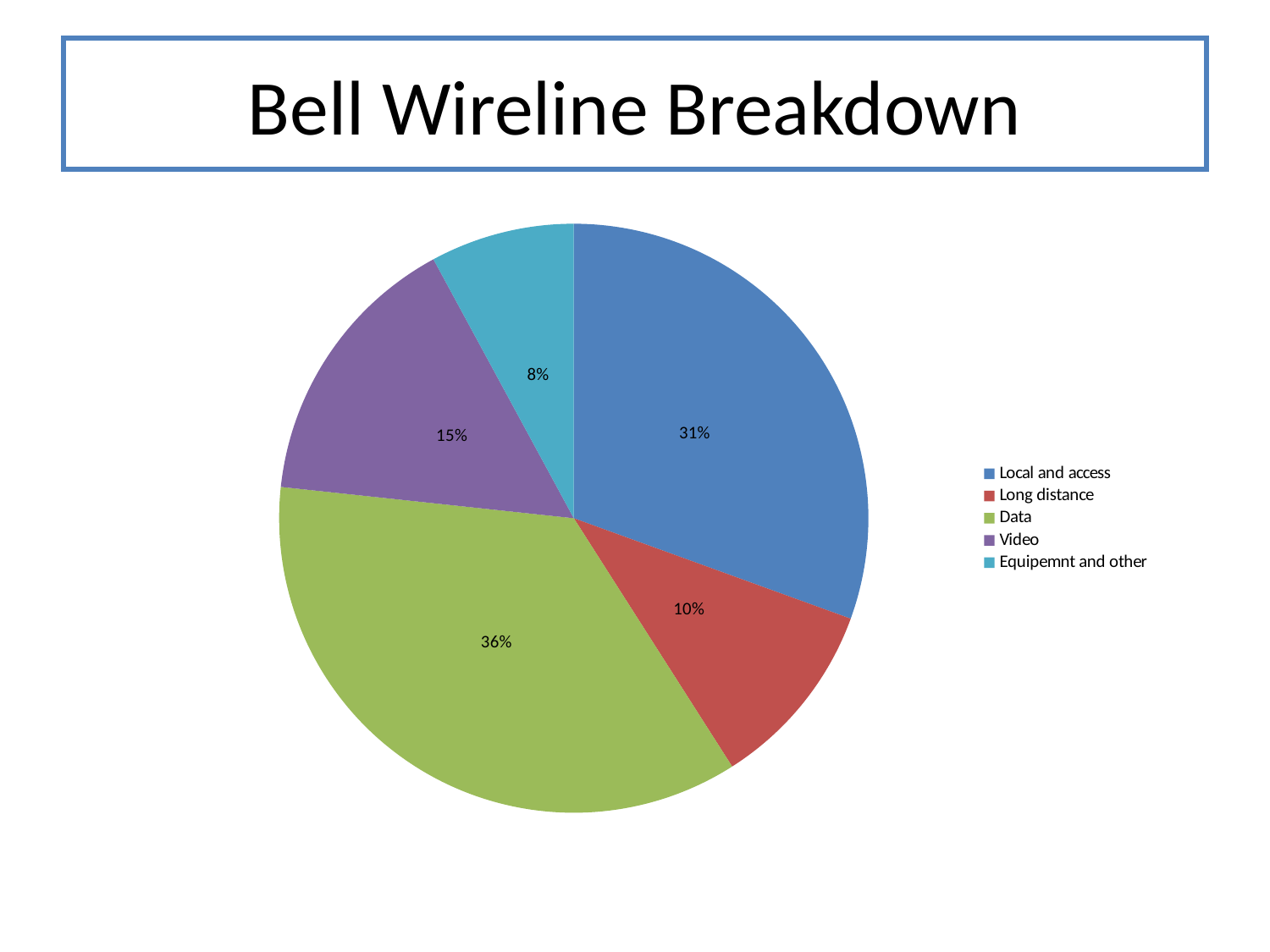
What is the title of the slide containing the chart? Bell Wireline Breakdown Which category has the largest slice of the pie? Data Which category has the smallest slice of the pie? Equipemnt and other What share of the pie does Data account for? 36% What share of the pie does Equipemnt and other account for? 8% Which is larger, the Video slice or the Long distance slice? Video What share of the pie does Video account for? 15% How many categories are shown in the pie chart? 5 What kind of chart is shown on the slide? Pie chart What is the difference in percentage points between the Data slice and the Local and access slice? 5 percentage points